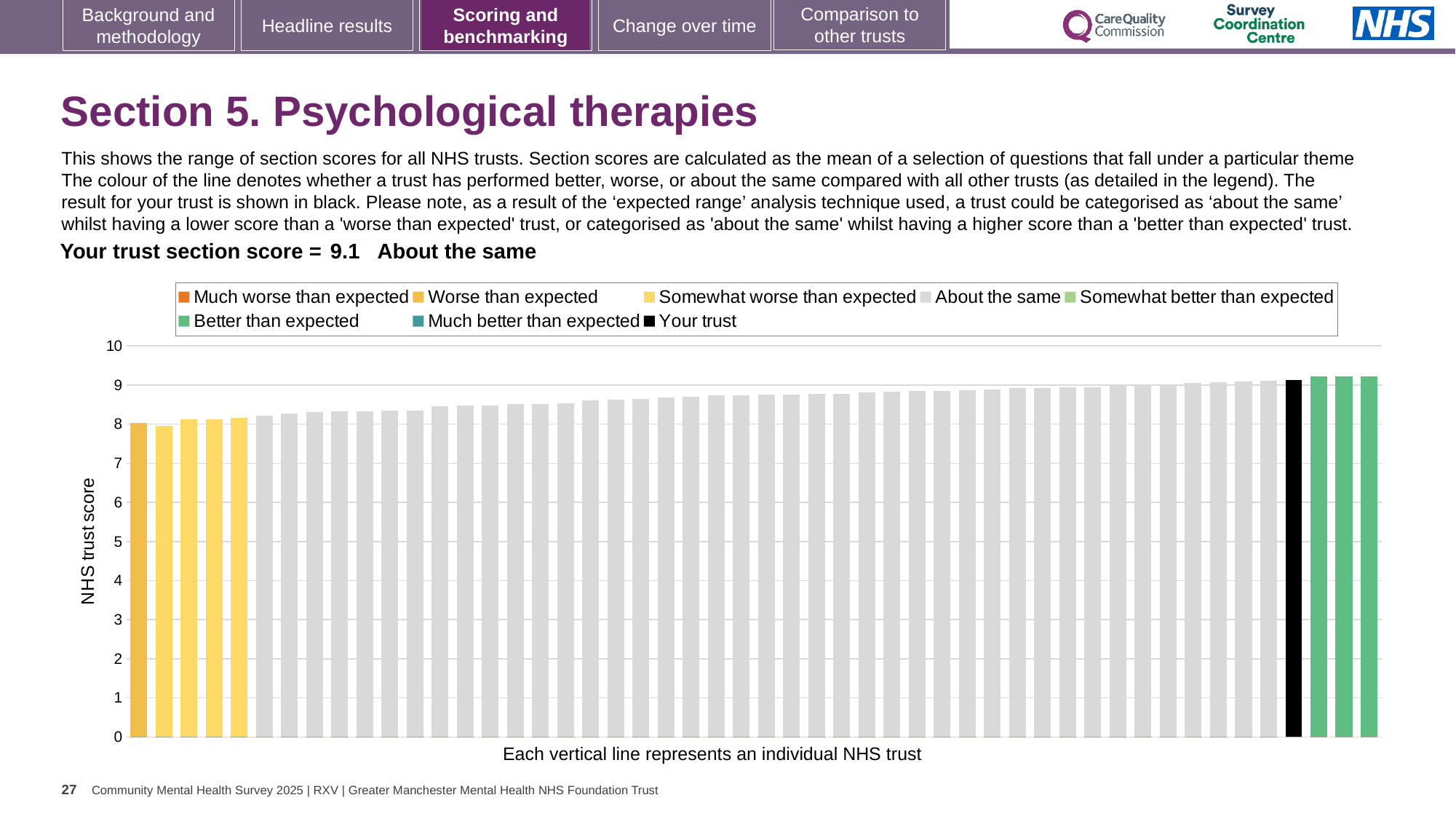
Which is larger, the value of the black 'Your trust' bar or the value of the leftmost bar? the black 'Your trust' bar Is the value of the leftmost bar greater or less than 7? greater Is the value of the leftmost bar greater or less than 9? less What kind of chart is shown on the slide? bar chart How many green bars are there at the right end of the chart? 3 What is the section score for your trust shown on the slide? 9.1 What category is your trust's section score placed in according to the slide? About the same What is the title of the y axis? NHS trust score How many entries does the chart legend list? 8 Do the bar values rise or fall from left to right along the x axis? rise Is the value of the black 'Your trust' bar greater or less than 9? greater